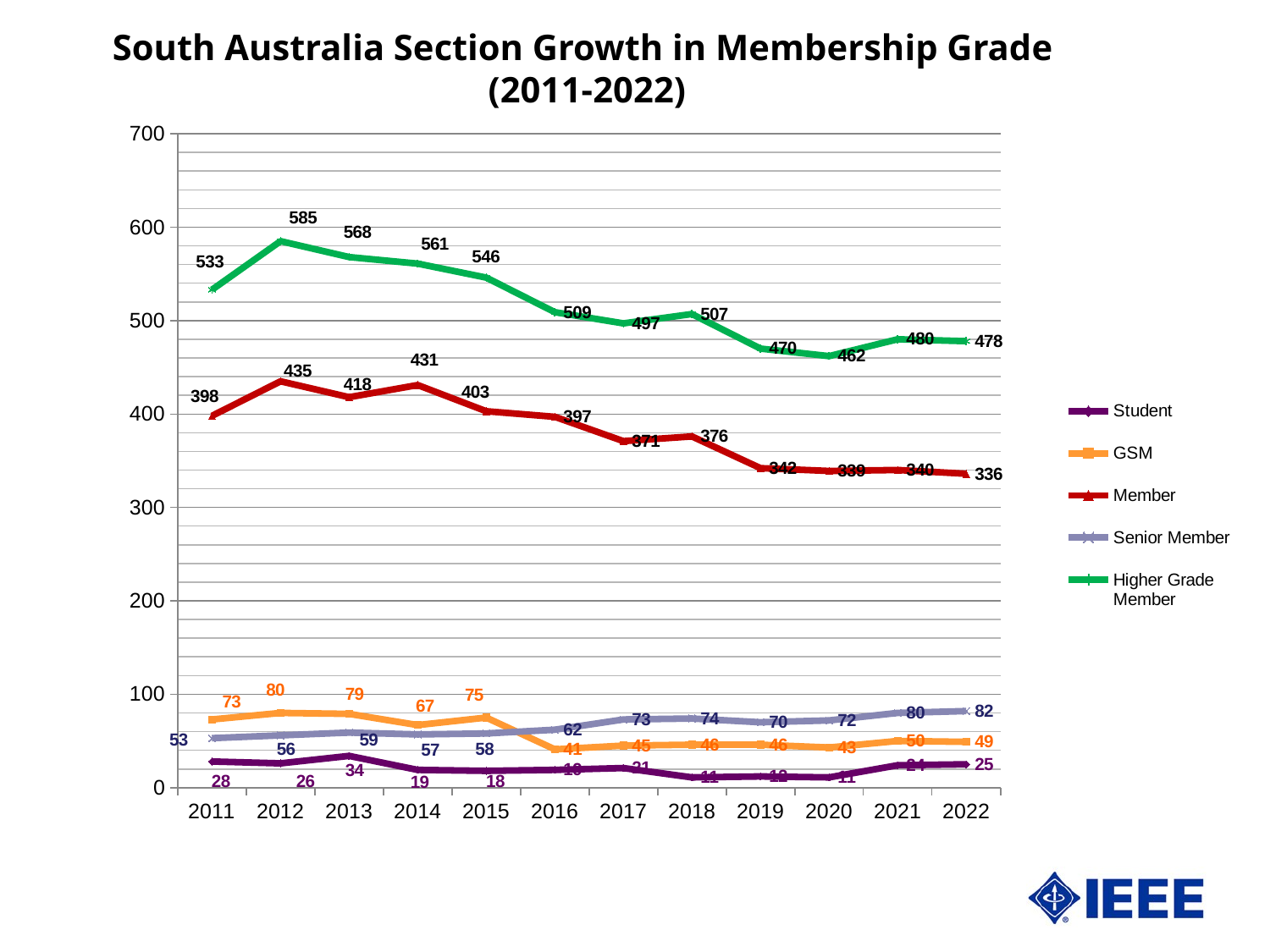
Which was larger in 2016, the GSM value or the Senior Member value? Senior Member What kind of chart is shown on the slide? Line chart In which year was the Member series at its lowest value? 2022 What is the difference between the Higher Grade Member values in 2011 and 2022? 55 What was the GSM value in 2011? 73 Does the Member series generally rise or fall from 2012 to 2022? Fall What was the Higher Grade Member value in 2012? 585 How many series does the legend list? 5 How many years are shown on the x axis? 12 What was the Senior Member value in 2022? 82 What was the Member value in 2022? 336 In which year did the Higher Grade Member series reach its highest value? 2012